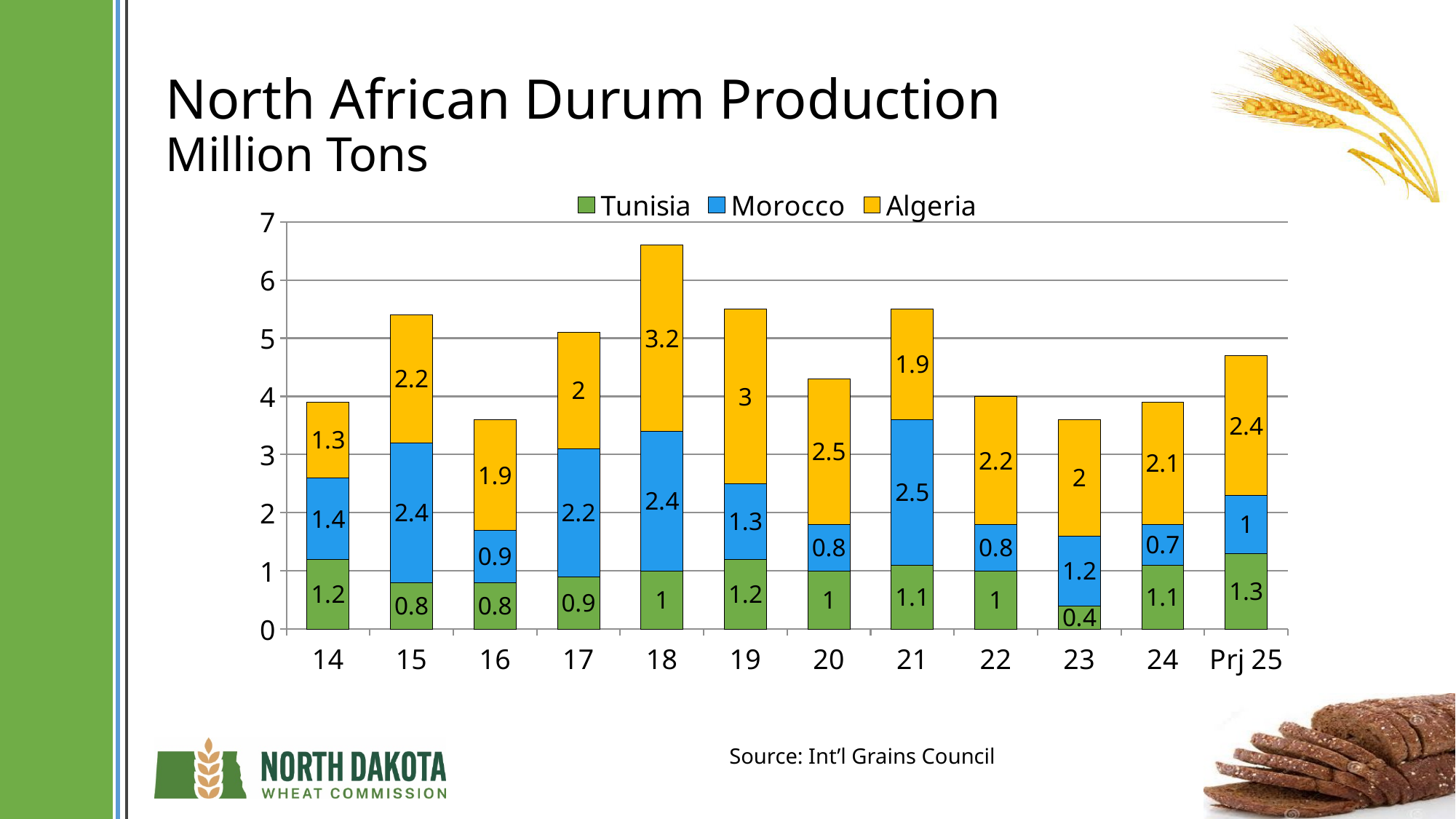
In which year is the Tunisia value lowest? 23 How many categories are shown on the x axis? 12 How many series does the legend list? 3 What is the Algeria value for 18? 3.2 What is the total of the stacked bar for 14? 3.9 What is the total of the stacked bar for 18? 6.6 In which year is the Algeria value highest? 18 What kind of chart is shown on the slide? Stacked bar chart What is the difference between the Morocco values for 21 and 24? 1.8 Which is larger, the Algeria value for 19 or the Algeria value for 21? 19 What is the Morocco value for Prj 25? 1 What is the Tunisia value for 23? 0.4